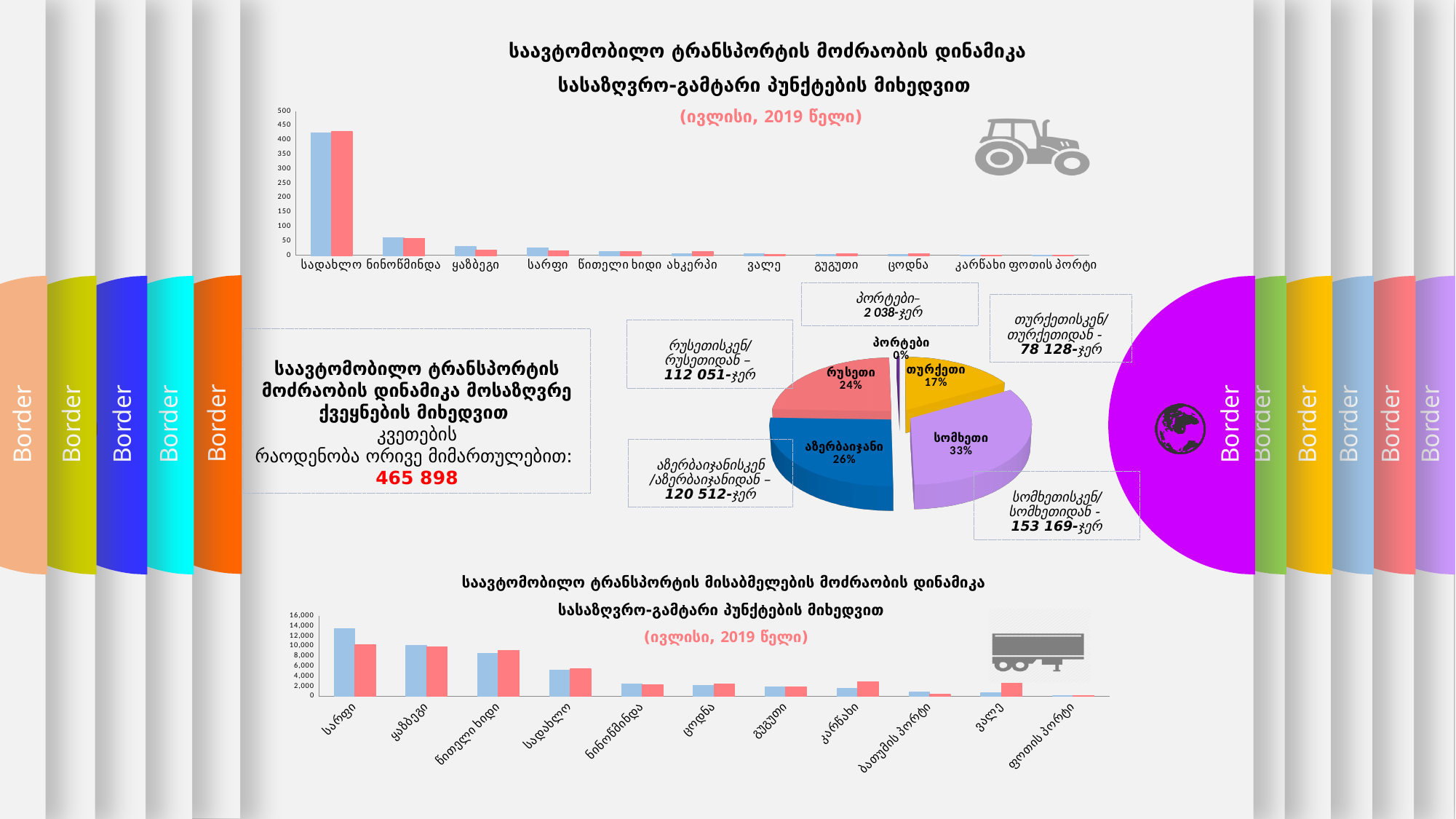
In the pie chart in the middle of the slide, which slice is the smallest? პორტები According to the callout next to the pie chart in the middle of the slide, how many times is the value for თურქეთისკენ/თურქეთიდან? 78 128-ჯერ What total number of vehicles in both directions is printed in the text box to the left of the pie chart? 465 898 In the pie chart in the middle of the slide, what share does სომხეთი have? 33% In the pie chart in the middle of the slide, what share does აზერბაიჯანი have? 26% In the pie chart in the middle of the slide, which slice is the largest? სომხეთი In the top bar chart, is the value of the blue bar for სადახლო greater or less than 400? greater In the bottom bar chart, which category has the highest value? სარფი In the top bar chart, how many categories are shown on the x axis? 11 In the pie chart in the middle of the slide, how many slices are there? 5 In the pie chart in the middle of the slide, what is the difference in percentage points between the shares of სომხეთი and რუსეთი? 9 What kind of chart is the top chart on the slide? bar chart